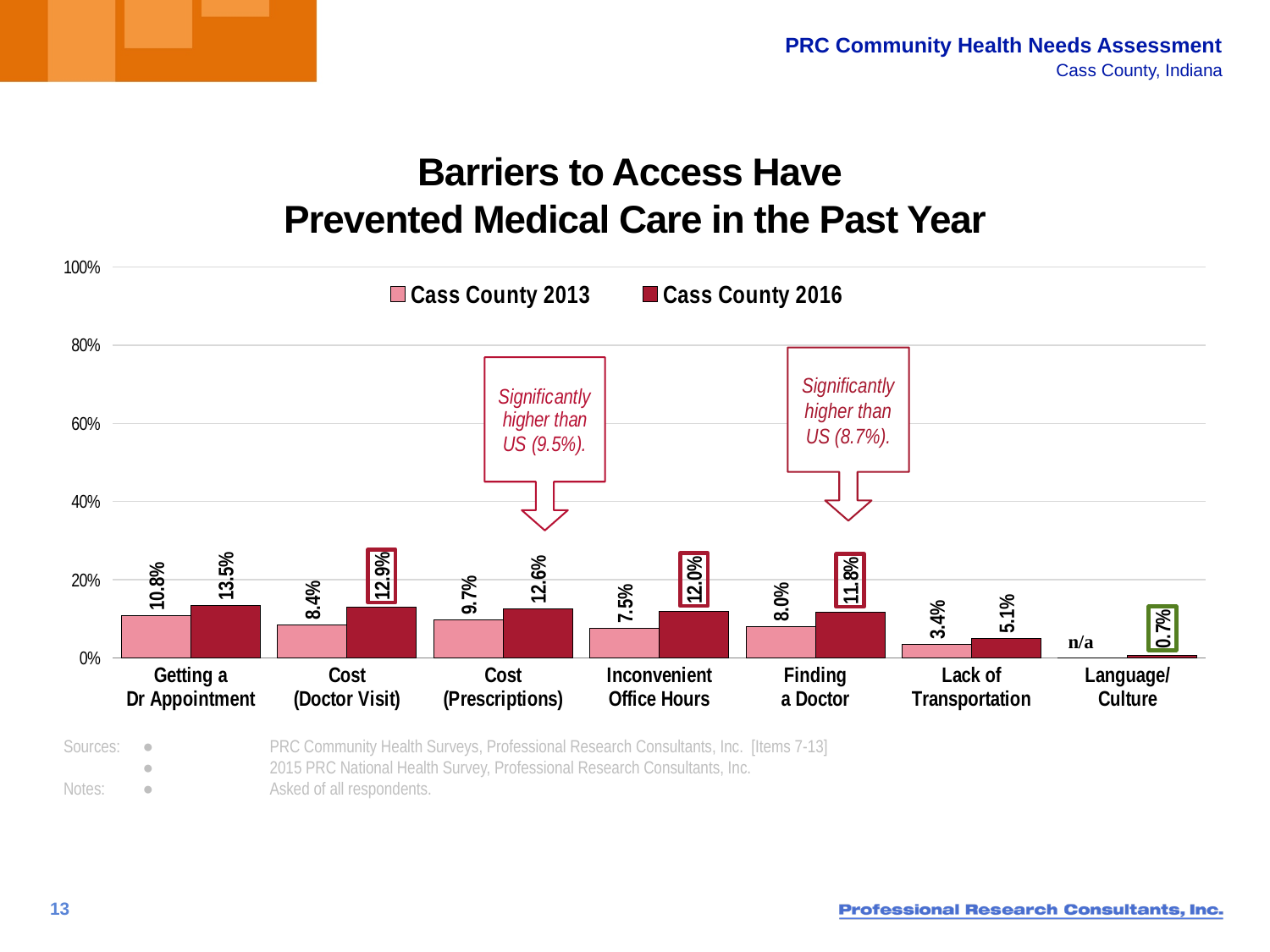
What is the difference between the Cass County 2016 and Cass County 2013 values for Cost (Doctor Visit)? 4.5% How many series does the legend list? 2 What is the Cass County 2013 value for Language/Culture? n/a Which is larger for Finding a Doctor: the Cass County 2013 value or the Cass County 2016 value? Cass County 2016 What is the Cass County 2016 value for Getting a Dr Appointment? 13.5% What is the Cass County 2013 value for Cost (Doctor Visit)? 8.4% Which category has the lowest Cass County 2016 value? Language/Culture What is the Cass County 2016 value for Inconvenient Office Hours? 12.0% Which category has the highest Cass County 2016 value? Getting a Dr Appointment What is the Cass County 2013 value for Lack of Transportation? 3.4% How many categories are shown on the x axis? 7 What kind of chart is shown on the slide? Bar chart